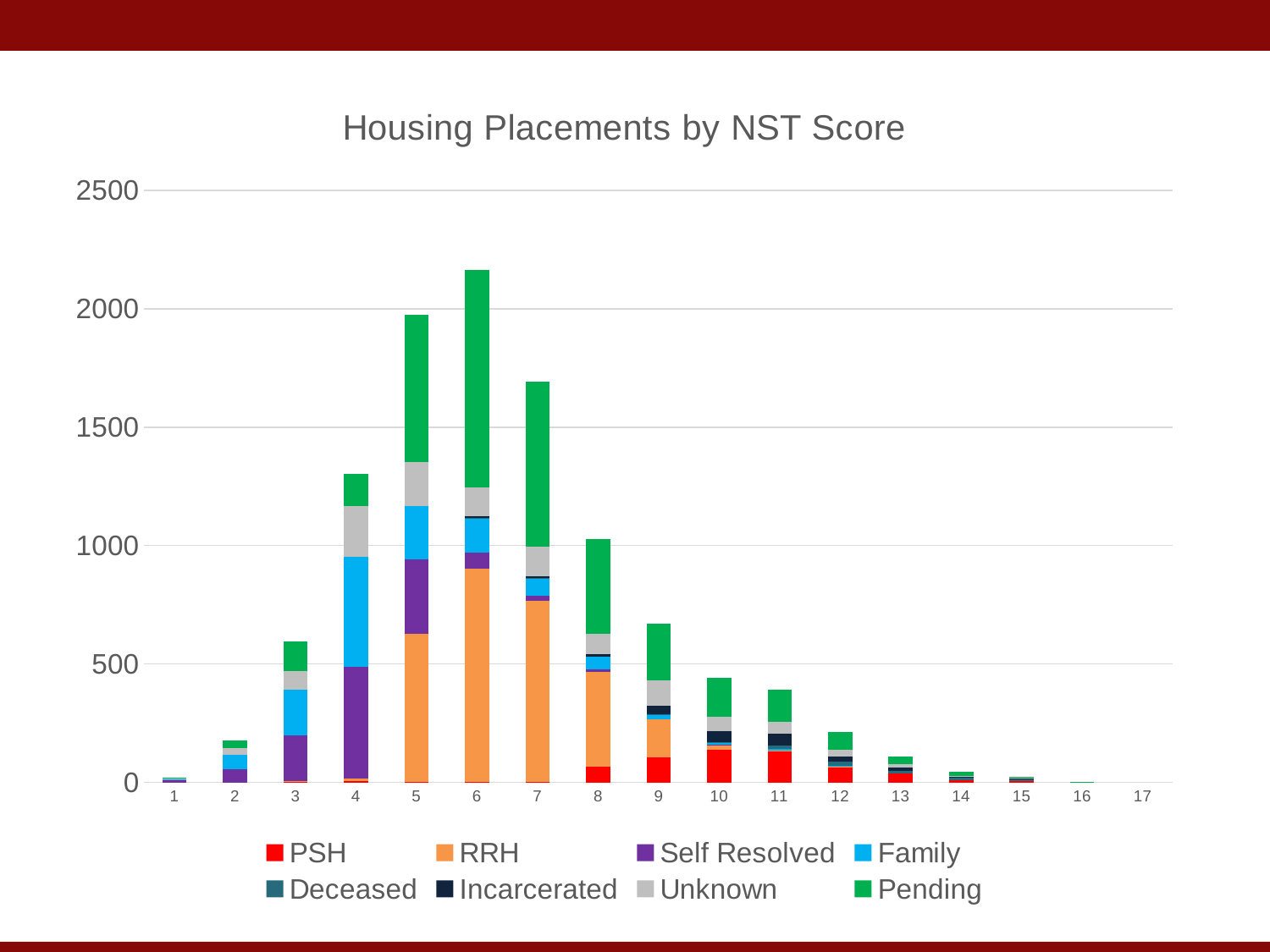
What kind of chart is shown on the slide? Stacked bar chart What is the title of the chart? Housing Placements by NST Score Is the total for NST score 5 greater or less than 1500? greater Do the bar totals rise or fall from NST score 6 to NST score 17? fall How many series does the legend list? 8 Which has the taller stacked bar, NST score 4 or NST score 8? 4 Is the total for NST score 4 greater or less than 1000? greater How many NST score categories are shown on the x axis? 17 Is the total for NST score 10 greater or less than 500? less Which has the taller stacked bar, NST score 5 or NST score 7? 5 Which NST score has the tallest stacked bar? 6